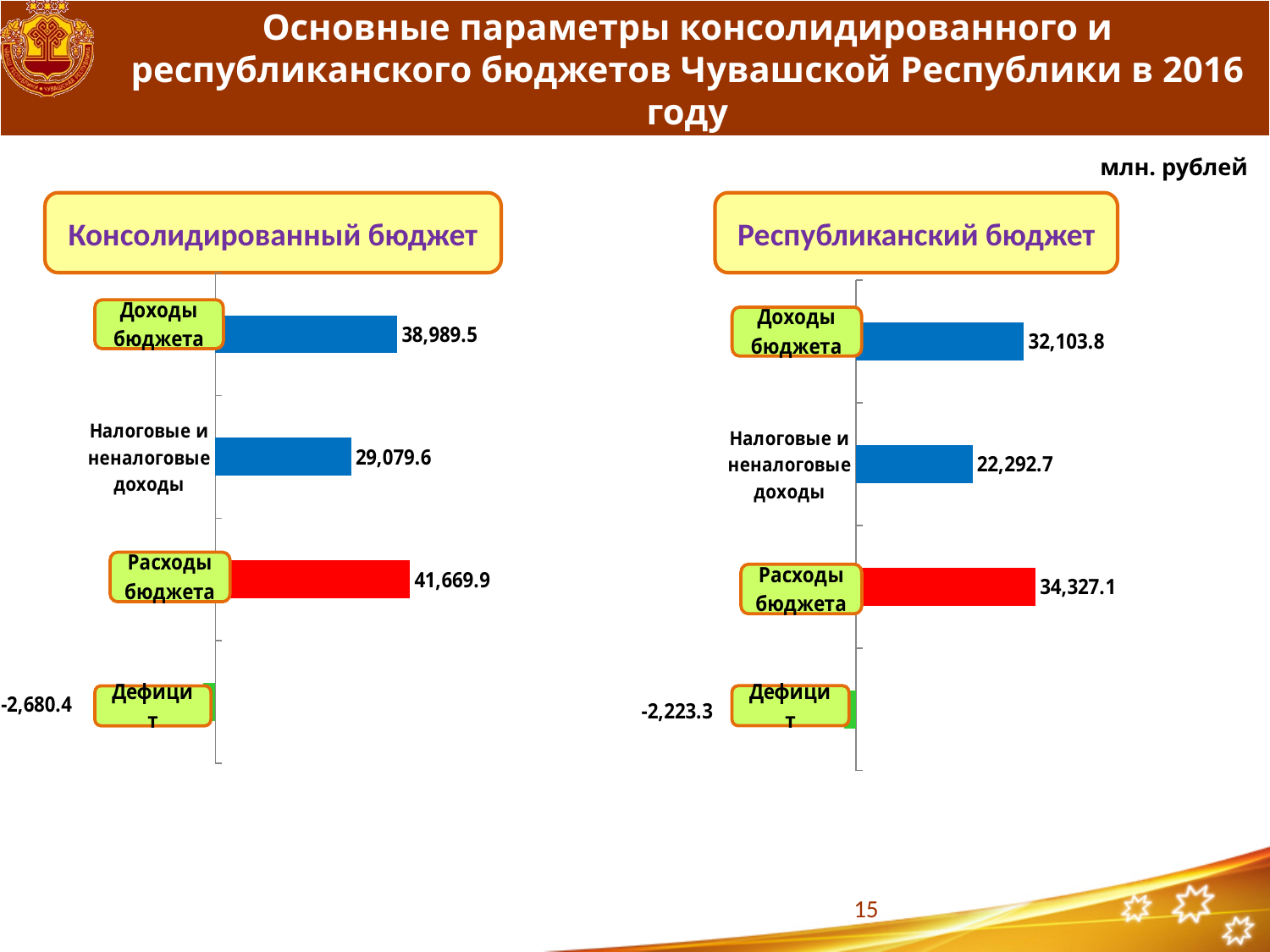
In the 'Республиканский бюджет' chart, what is the difference between 'Доходы бюджета' and 'Налоговые и неналоговые доходы'? 9,811.1 How many categories are shown in the 'Республиканский бюджет' chart? 4 In the 'Консолидированный бюджет' chart, what is the difference between 'Расходы бюджета' and 'Доходы бюджета'? 2,680.4 What type of chart is the 'Консолидированный бюджет' chart? Bar chart In the 'Консолидированный бюджет' chart, what is the value for 'Расходы бюджета'? 41,669.9 In the 'Республиканский бюджет' chart, what is the value for 'Налоговые и неналоговые доходы'? 22,292.7 In the 'Консолидированный бюджет' chart, what colour is the bar for 'Расходы бюджета'? Red In the 'Консолидированный бюджет' chart, what is the value for 'Доходы бюджета'? 38,989.5 In the 'Республиканский бюджет' chart, which category has the lowest value? Дефицит Which is larger: 'Доходы бюджета' in the 'Консолидированный бюджет' chart or 'Доходы бюджета' in the 'Республиканский бюджет' chart? Консолидированный бюджет In the 'Республиканский бюджет' chart, what is the value for 'Дефицит'? -2,223.3 In the 'Консолидированный бюджет' chart, which category has the highest value? Расходы бюджета